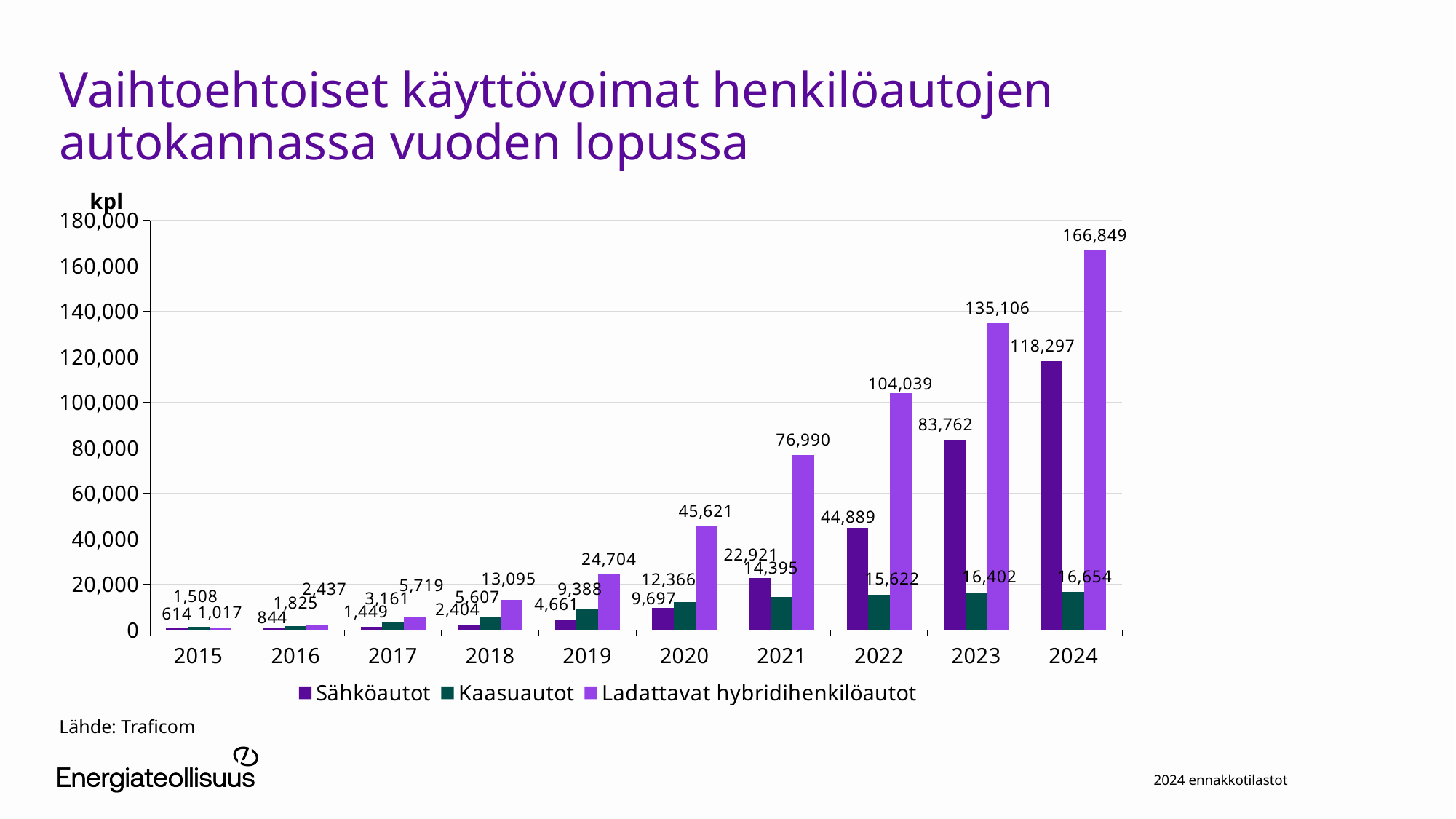
What is the value for Kaasuautot in 2020? 12,366 What is the difference between the Ladattavat hybridihenkilöautot values for 2024 and 2023? 31,743 Do the values for Sähköautot rise or fall from 2015 to 2024? Rise What is the value for Ladattavat hybridihenkilöautot in 2021? 76,990 How many years are shown on the x axis? 10 In which year is the value for Ladattavat hybridihenkilöautot highest? 2024 How many series does the legend list? 3 In 2021, which is larger: Sähköautot or Kaasuautot? Sähköautot What is the value for Sähköautot in 2024? 118,297 What kind of chart is shown on the slide? Bar chart In which year is the value for Sähköautot lowest? 2015 What is the difference between the Sähköautot values for 2024 and 2023? 34,535